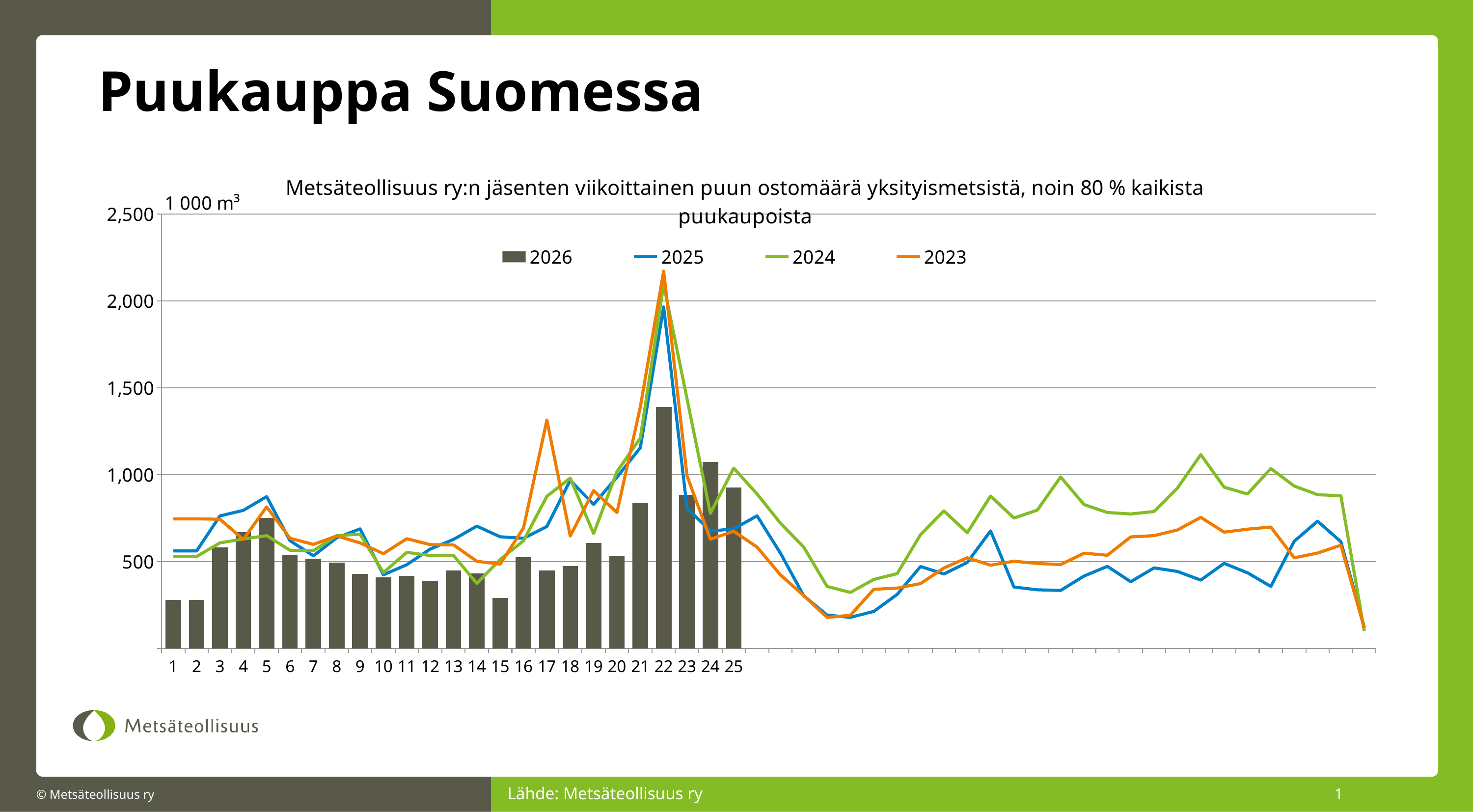
Which series reaches the highest peak at week 22? 2023 Is the 2026 value for week 22 greater or less than 1,000? greater Is the 2023 value at week 17 greater or less than 1,000? greater What unit is shown above the y axis? 1 000 m³ What kind of chart is shown on the slide? A combined bar and line chart Which series is plotted as bars? 2026 How many weeks have a 2026 bar plotted? 25 How many series does the chart legend list? 4 Which week has the highest 2026 bar? 22 Is the 2026 value for week 24 greater or less than 1,000? greater Which is larger, the 2026 bar for week 5 or for week 6? Week 5